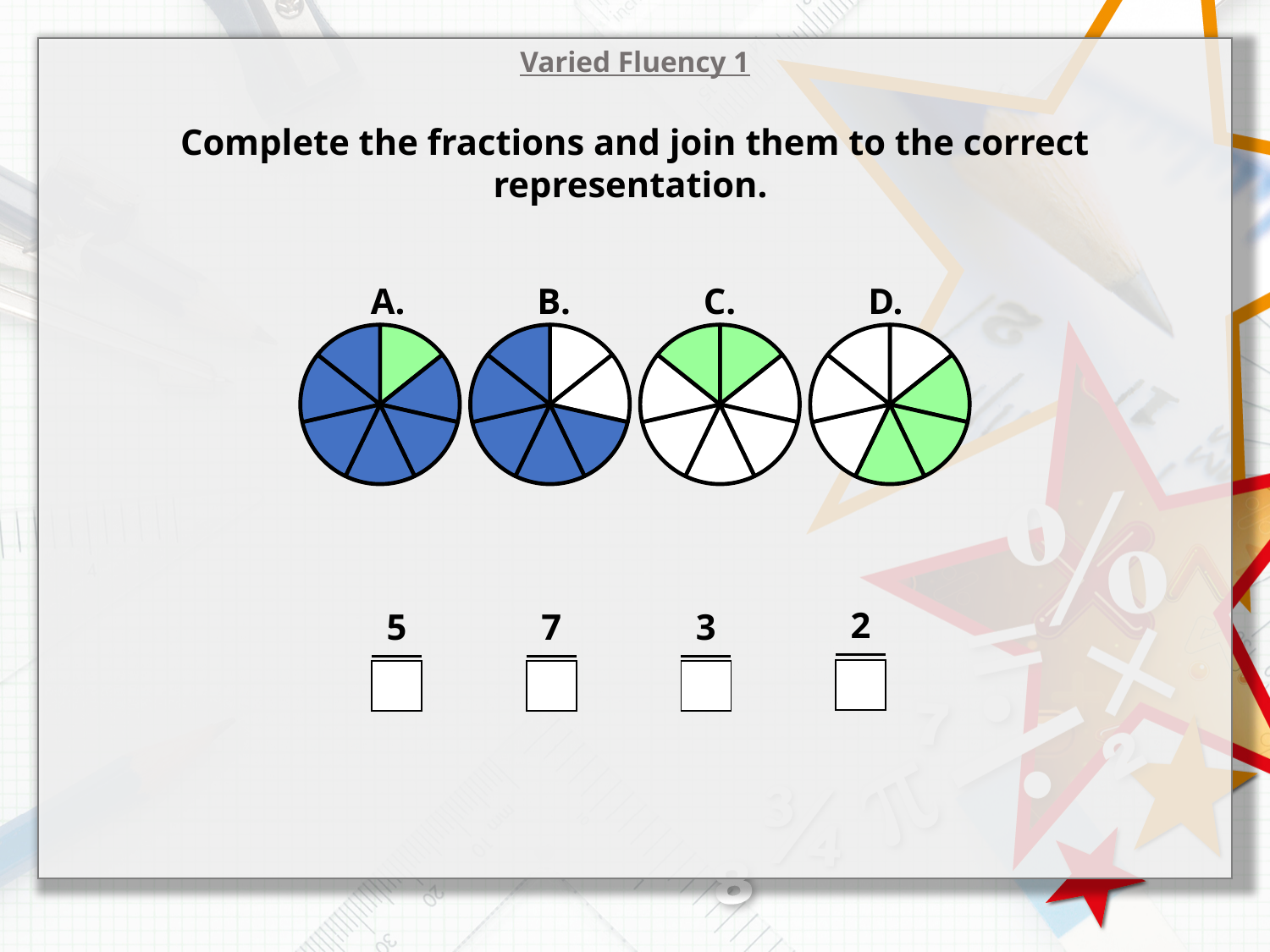
What colour is the shaded part of circle A? blue and green Is the shaded share of circle A greater or less than half? greater Is the shaded share of circle C greater or less than half? less Which circle has the largest shaded share, A or C? A What colour is the shaded part of circle D? green Which circle has the smallest shaded share, A or C? C How many circle diagrams are shown on the slide? 4 Is the shaded share of circle D greater or less than half? less What kind of chart are the four diagrams labelled A to D? pie chart